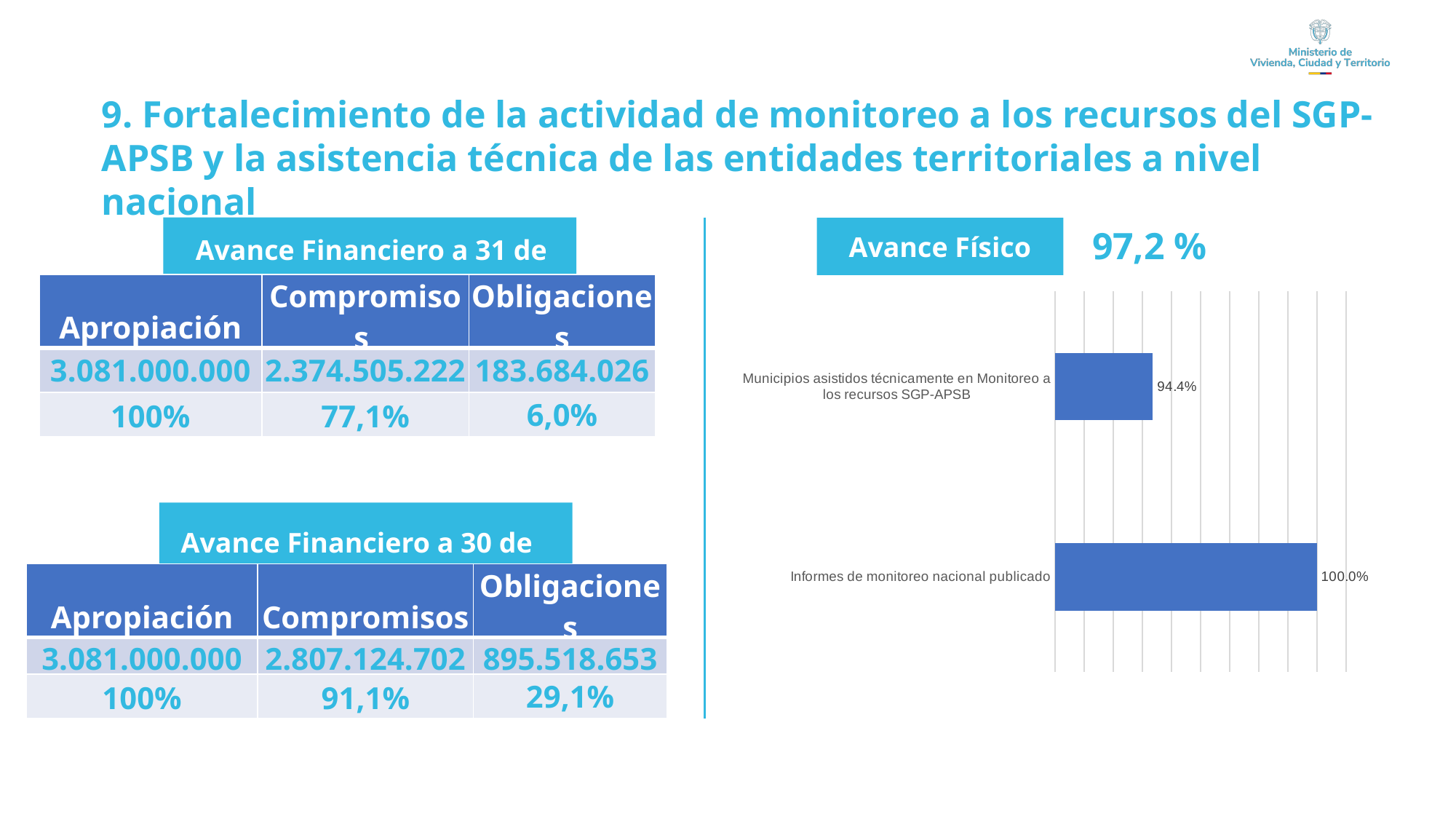
What is the title shown above the bar chart on the right of the slide? Avance Físico What kind of chart is the Avance Físico chart? Bar chart Are the bars in the Avance Físico chart horizontal or vertical? Horizontal What is the value for 'Municipios asistidos técnicamente en Monitoreo a los recursos SGP-APSB' in the Avance Físico chart? 94.4% What is the value for 'Informes de monitoreo nacional publicado' in the Avance Físico chart? 100.0% In the Avance Físico chart, which is larger: the value for 'Informes de monitoreo nacional publicado' or the value for 'Municipios asistidos técnicamente en Monitoreo a los recursos SGP-APSB'? Informes de monitoreo nacional publicado Which category has the highest value in the Avance Físico chart? Informes de monitoreo nacional publicado In the Avance Físico chart, what is the difference between the value for 'Informes de monitoreo nacional publicado' and the value for 'Municipios asistidos técnicamente en Monitoreo a los recursos SGP-APSB'? 5.6% How many categories are plotted in the Avance Físico chart? 2 Which category has the lowest value in the Avance Físico chart? Municipios asistidos técnicamente en Monitoreo a los recursos SGP-APSB